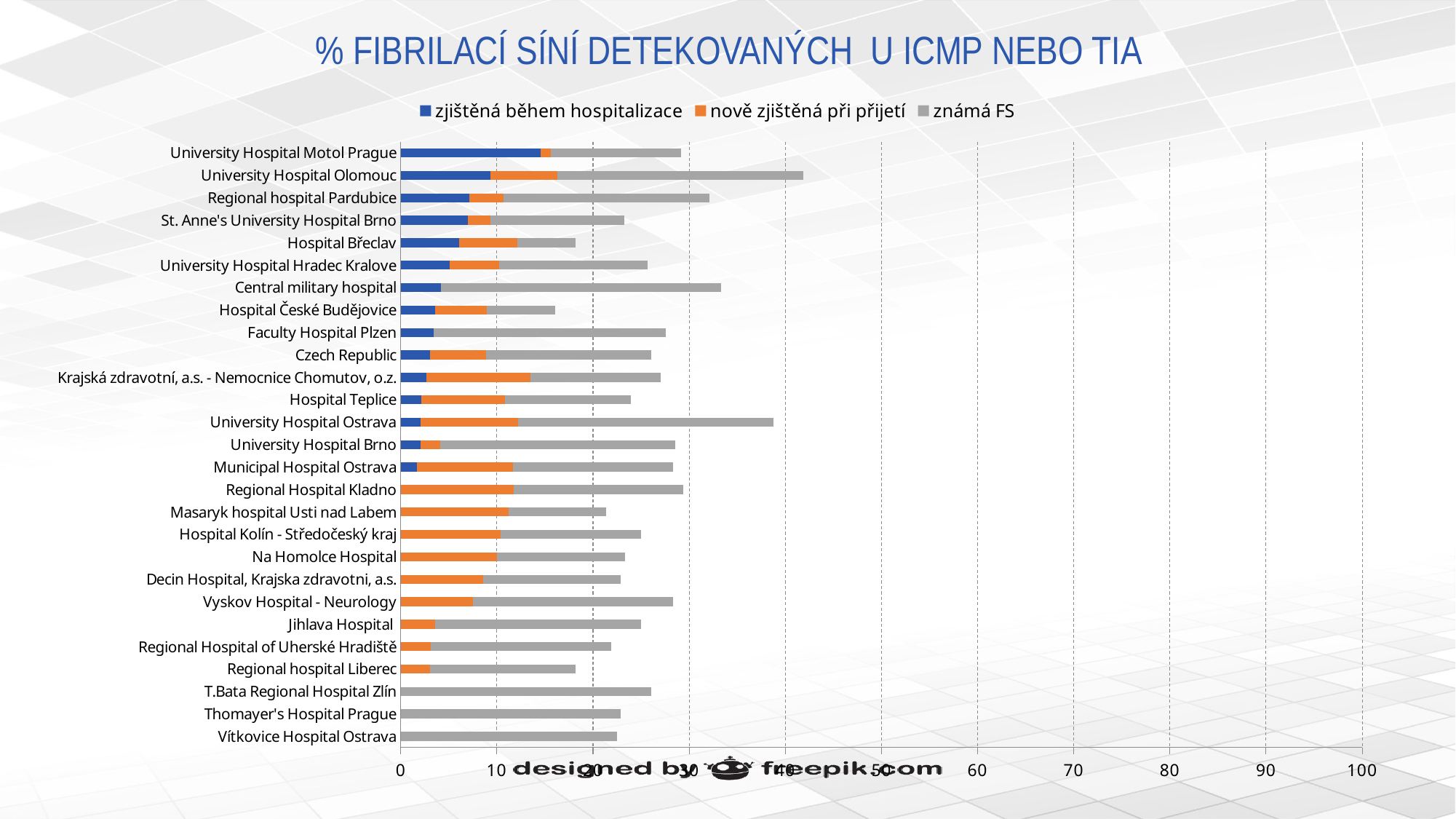
Is the total bar for Hospital Břeclav greater or less than 20? less Is the total bar for Central military hospital greater or less than 30? greater What is the title of the chart? % FIBRILACÍ SÍNÍ DETEKOVANÝCH U ICMP NEBO TIA Which category has the longest total bar? University Hospital Olomouc Is the total bar for University Hospital Olomouc greater or less than 40? greater Which series is shown in orange in the legend? nově zjištěná při přijetí What kind of chart is shown on the slide? Stacked bar chart How many series does the legend list? 3 How many hospitals/categories are plotted on the chart? 27 Which has the larger value for 'zjištěná během hospitalizace': University Hospital Motol Prague or University Hospital Olomouc? University Hospital Motol Prague Which category has the largest value for the series 'zjištěná během hospitalizace'? University Hospital Motol Prague